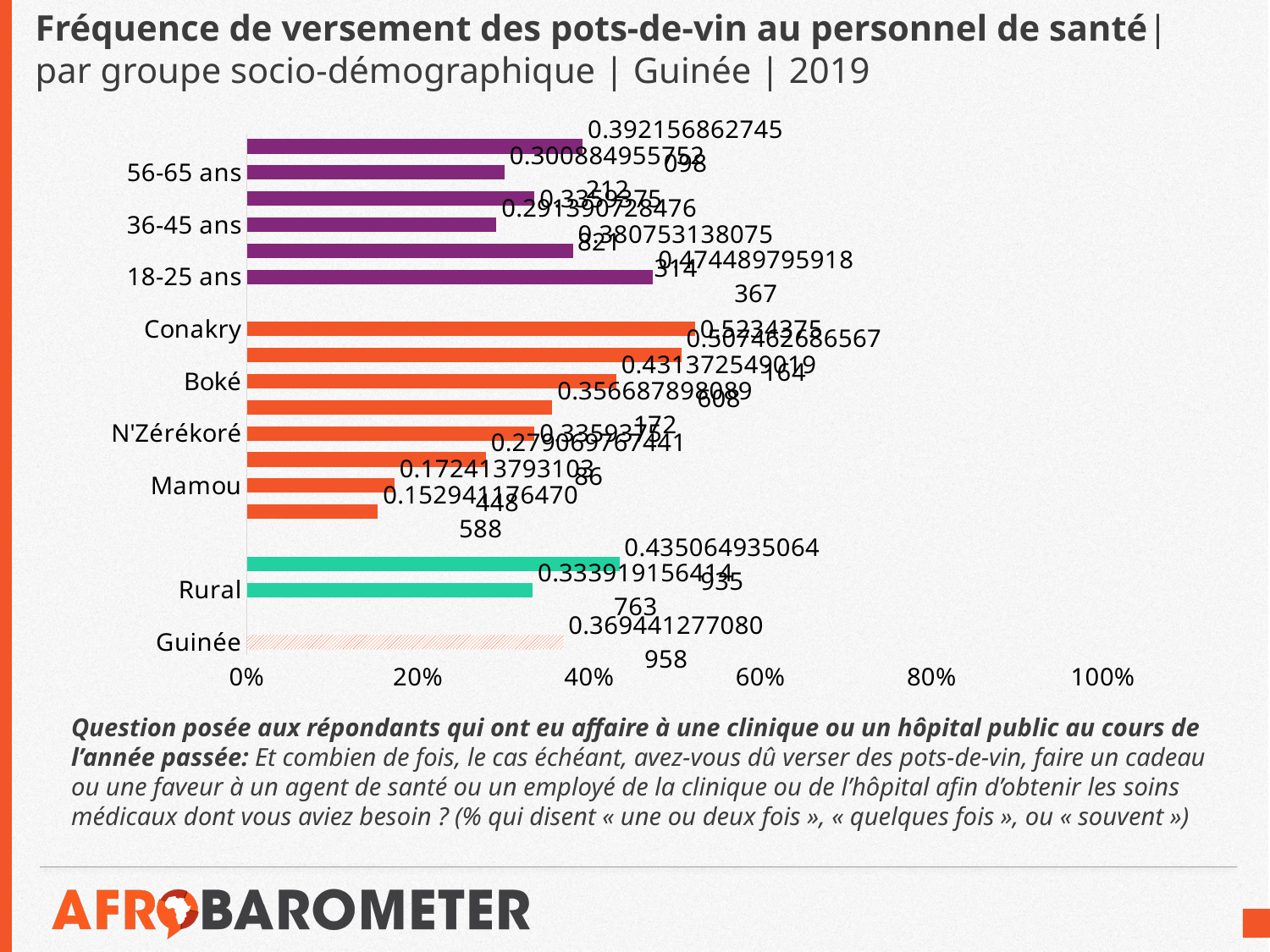
What is the value shown for Guinée? 0.369441277080958 Is the value for Mamou greater or less than 20%? less What colour are the bars for Rural? Green Which labelled category has the lowest value? Mamou Which has the larger value, 18-25 ans or 56-65 ans? 18-25 ans What is the value shown for Conakry? 0.5234375 Which labelled category has the highest value? Conakry What kind of chart is shown on the slide? Bar chart Is the value for Conakry greater or less than 40%? greater What is the value shown for 18-25 ans? 0.474489795918367 What is the value shown for Mamou? 0.172413793103448 Which has the larger value, Conakry or Boké? Conakry